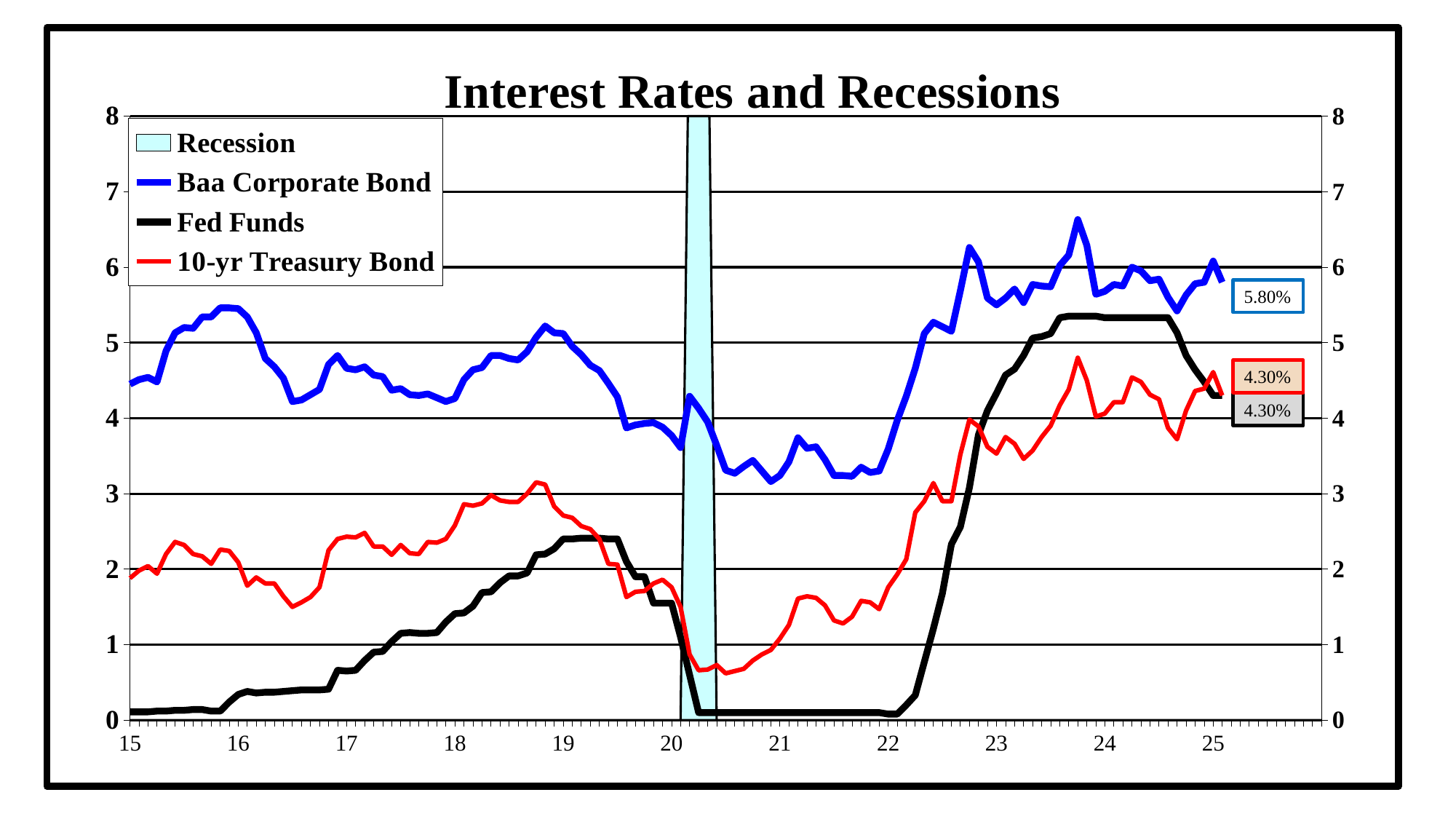
Does the Fed Funds series rise or fall between 2022 and 2023? rise What is the latest labelled value for the Fed Funds series? 4.30% What is the latest labelled value for the 10-yr Treasury Bond series? 4.30% What is the title of the chart? Interest Rates and Recessions What is the difference between the latest labelled Baa Corporate Bond value and the latest labelled 10-yr Treasury Bond value? 1.50% Is the Fed Funds value during 2021 greater or less than 1? less How many entries does the legend list? 4 What is the latest labelled value for the Baa Corporate Bond series? 5.80% What colour is the Fed Funds line? Black At the end of the chart, which series has the higher labelled value: Baa Corporate Bond or Fed Funds? Baa Corporate Bond Is the Fed Funds value in early 2024 greater or less than 5? greater What kind of chart is shown on the slide? Line chart